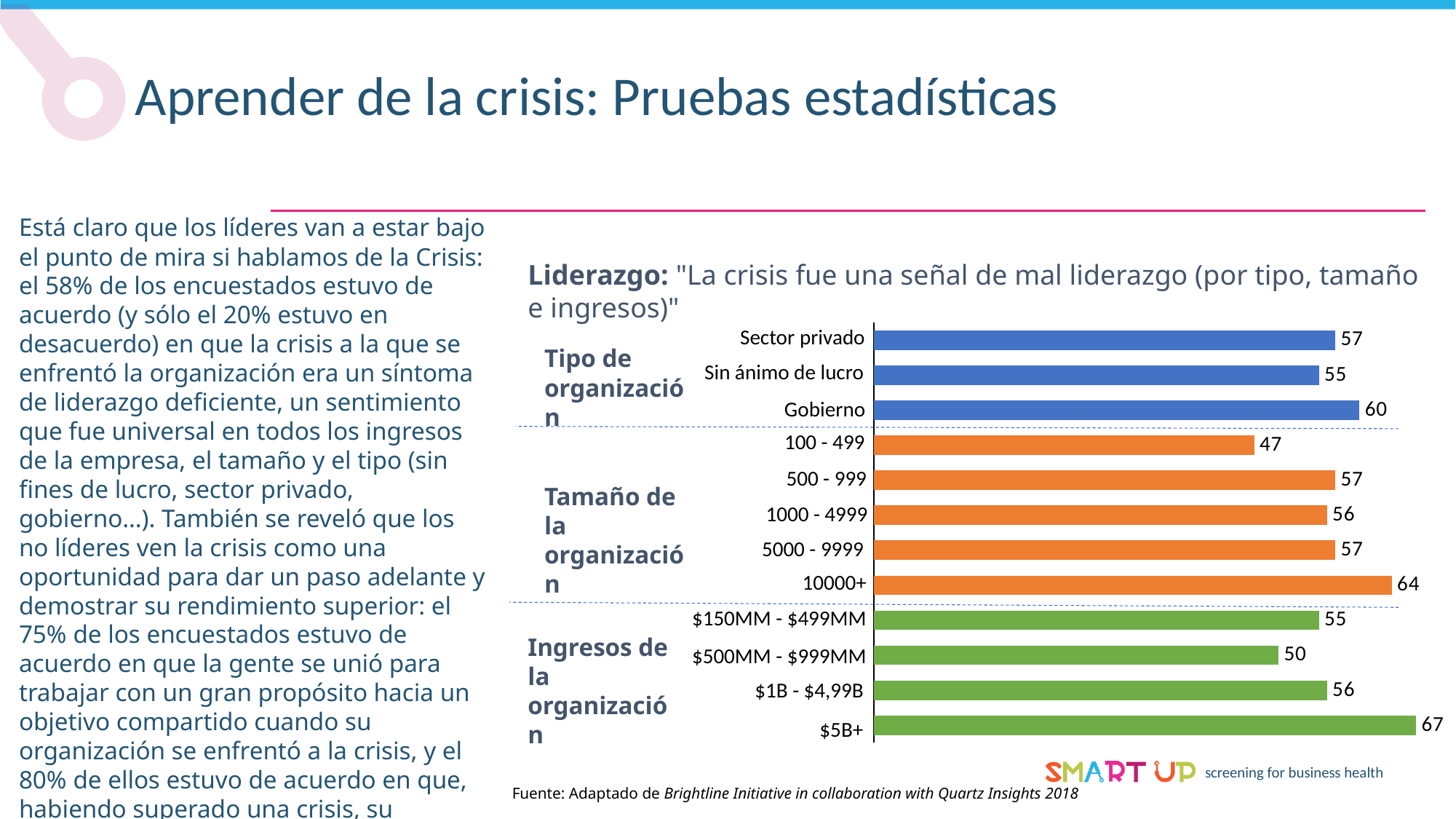
Which category has the lowest value in the chart? 100 - 499 What value is shown for $500MM - $999MM? 50 What value is shown for the 100 - 499 organization size category? 47 What is the difference between the values for 10000+ and 100 - 499? 17 What value is shown for $5B+? 67 What is the difference between the values for $5B+ and $1B - $4,99B? 11 Which is larger, the value for Gobierno or the value for Sin ánimo de lucro? Gobierno What type of chart is shown on the slide? Bar chart How many categories (bars) are plotted in the chart? 12 What colour are the bars for the 'Ingresos de la organización' group? Green What value is shown for Gobierno? 60 Which category has the highest value in the chart? $5B+